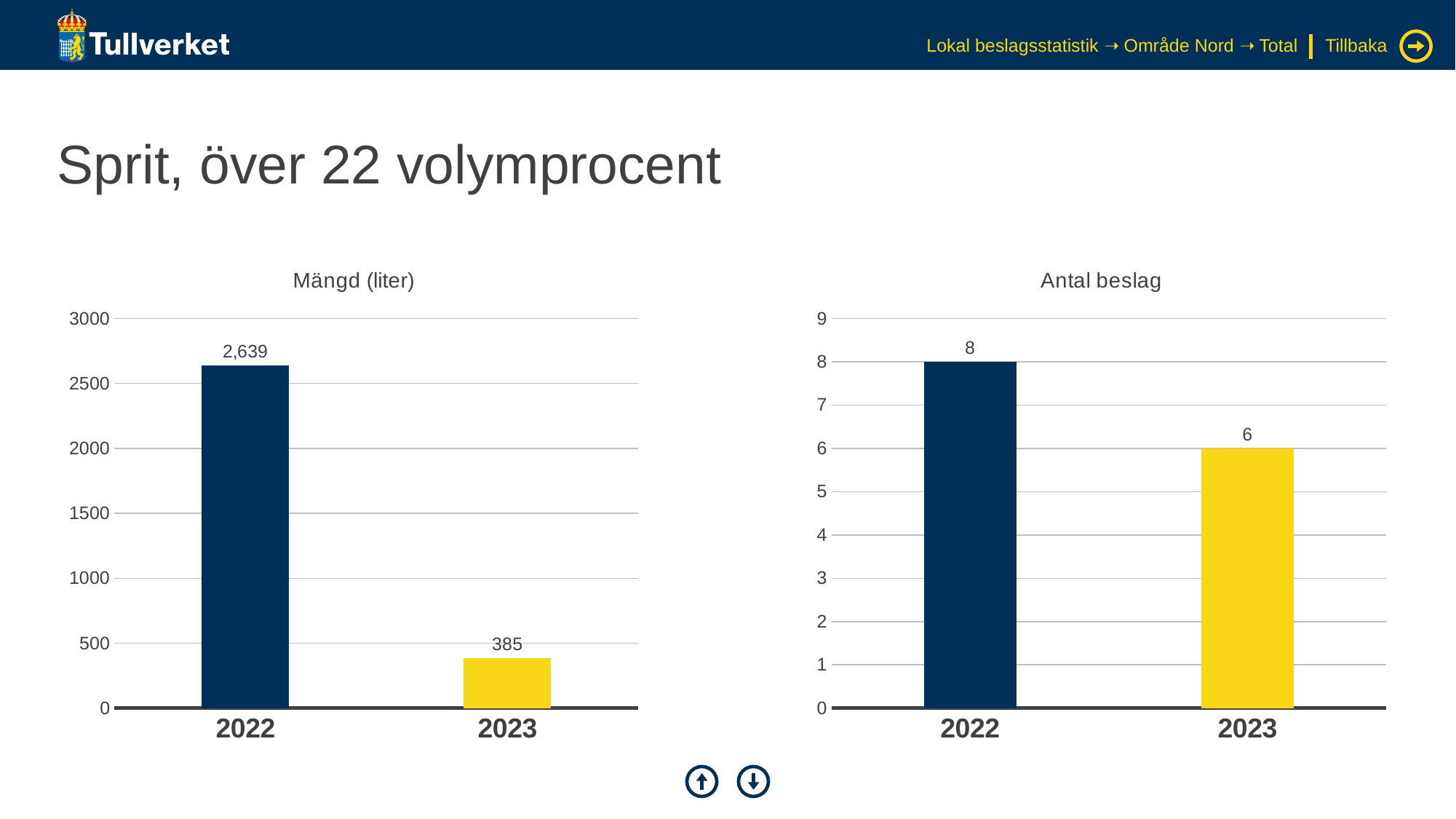
In the 'Antal beslag' chart, what is the difference between the 2022 and 2023 values? 2 In the 'Mängd (liter)' chart, what is the difference between the 2022 and 2023 values? 2,254 In the 'Mängd (liter)' chart, is the value for 2023 greater or less than 500? less In the 'Antal beslag' chart, what is the value for 2022? 8 In the 'Mängd (liter)' chart, what is the value for 2022? 2,639 How many categories are shown on the x axis of the 'Antal beslag' chart? 2 In the 'Mängd (liter)' chart, which year has the highest value? 2022 In the 'Antal beslag' chart, is the value for 2022 larger or smaller than the value for 2023? larger In the 'Mängd (liter)' chart, what is the value for 2023? 385 In the 'Antal beslag' chart, what is the value for 2023? 6 In the 'Antal beslag' chart, which year has the lowest value? 2023 What kind of chart is the 'Mängd (liter)' chart? bar chart